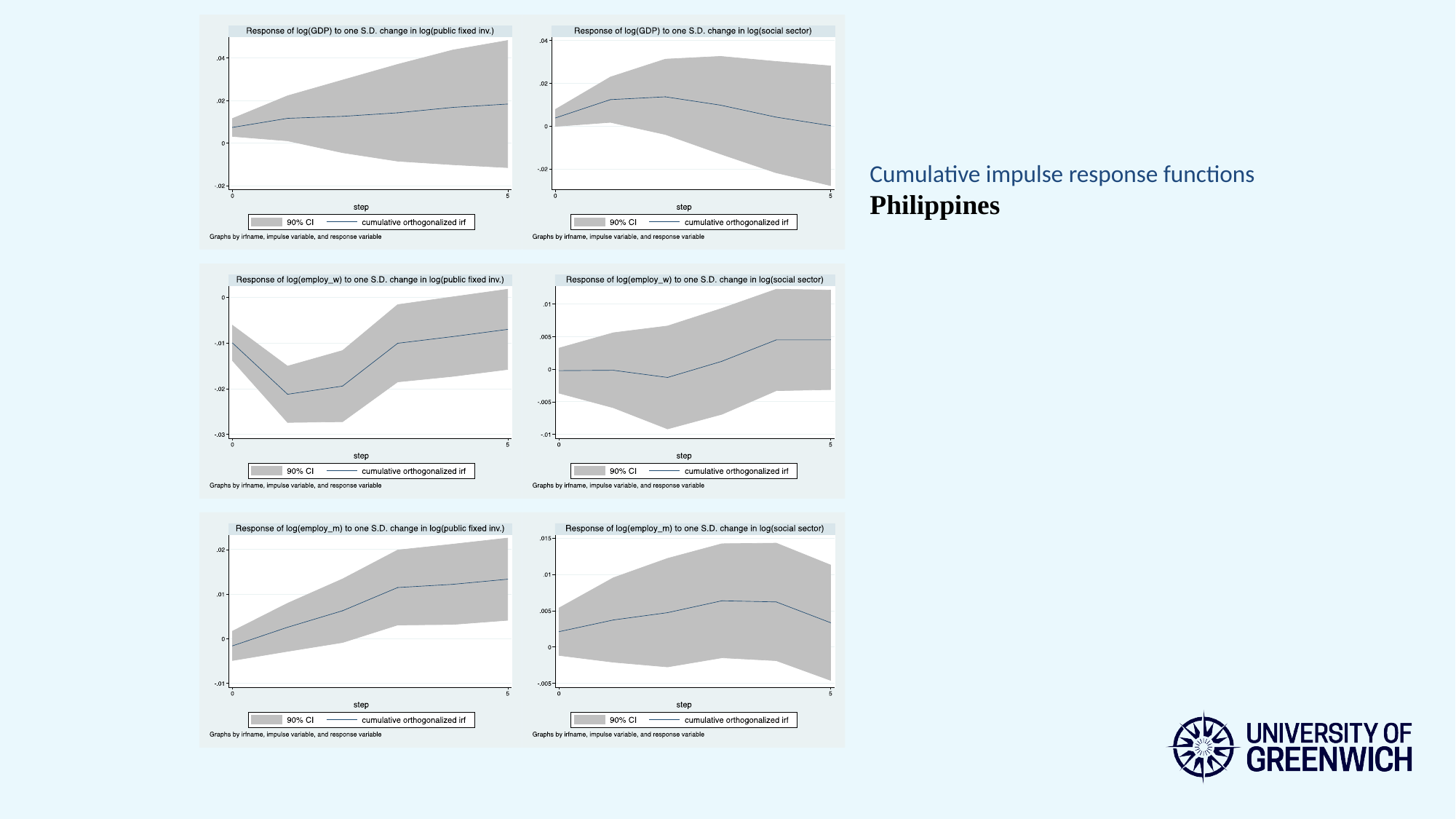
What kind of chart is the top-left chart, 'Response of log(GDP) to one S.D. change in log(public fixed inv.)'? line chart In the top-right chart, 'Response of log(GDP) to one S.D. change in log(social sector)', is the cumulative orthogonalized irf value at step 2 greater or less than .02? less In the top-left chart, 'Response of log(GDP) to one S.D. change in log(public fixed inv.)', does the cumulative orthogonalized irf line rise or fall from step 0 to step 5? rise How many entries does the legend of the top-left chart, 'Response of log(GDP) to one S.D. change in log(public fixed inv.)', list? 2 What are the two legend entries shown under the bottom-right chart, 'Response of log(employ_m) to one S.D. change in log(social sector)'? 90% CI and cumulative orthogonalized irf In the middle-right chart, 'Response of log(employ_w) to one S.D. change in log(social sector)', is the cumulative orthogonalized irf value at step 5 greater or less than 0? greater In the bottom-left chart, 'Response of log(employ_m) to one S.D. change in log(public fixed inv.)', is the cumulative orthogonalized irf value at step 5 greater or less than .01? greater In the bottom-left chart, 'Response of log(employ_m) to one S.D. change in log(public fixed inv.)', does the cumulative orthogonalized irf line rise or fall from step 0 to step 5? rise In the middle-left chart, 'Response of log(employ_w) to one S.D. change in log(public fixed inv.)', at which step is the cumulative orthogonalized irf lowest? step 1 In the top-right chart, 'Response of log(GDP) to one S.D. change in log(social sector)', does the cumulative orthogonalized irf line rise or fall between step 2 and step 5? fall